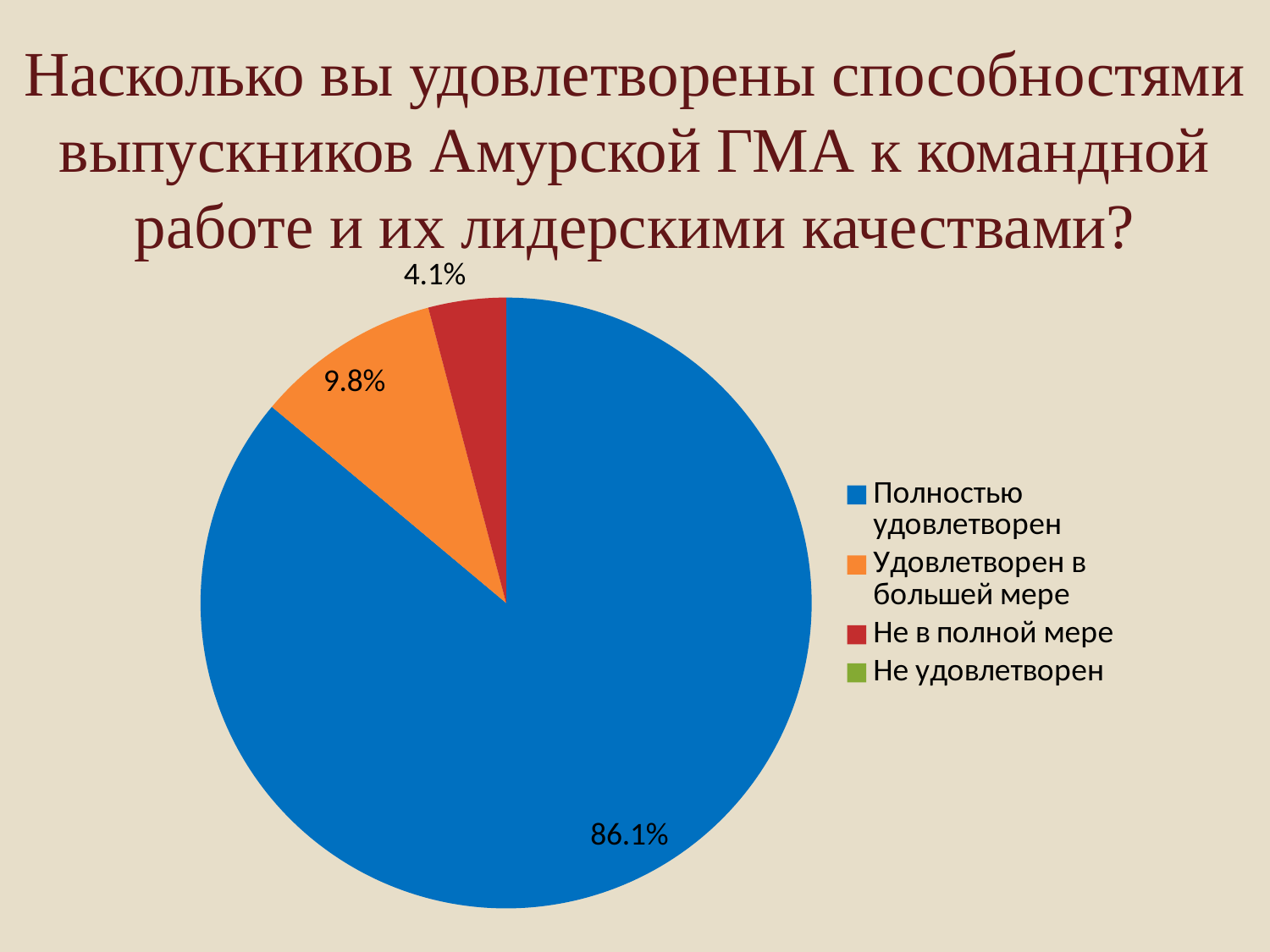
What is the difference between the shares for "Удовлетворен в большей мере" and "Не в полной мере"? 5.7% How many entries does the legend list? 4 Which colour represents "Полностью удовлетворен" in the chart? blue Which legend entry has no visible slice in the pie? Не удовлетворен What share of respondents answered "Удовлетворен в большей мере"? 9.8% What share of respondents answered "Полностью удовлетворен"? 86.1% What share of respondents answered "Не в полной мере"? 4.1% Which is larger: the share for "Удовлетворен в большей мере" or for "Не в полной мере"? Удовлетворен в большей мере Which category has the largest slice of the pie? Полностью удовлетворен Which of the visible slices is the smallest? Не в полной мере What is the difference between the shares for "Полностью удовлетворен" and "Удовлетворен в большей мере"? 76.3% What kind of chart is shown on the slide? pie chart